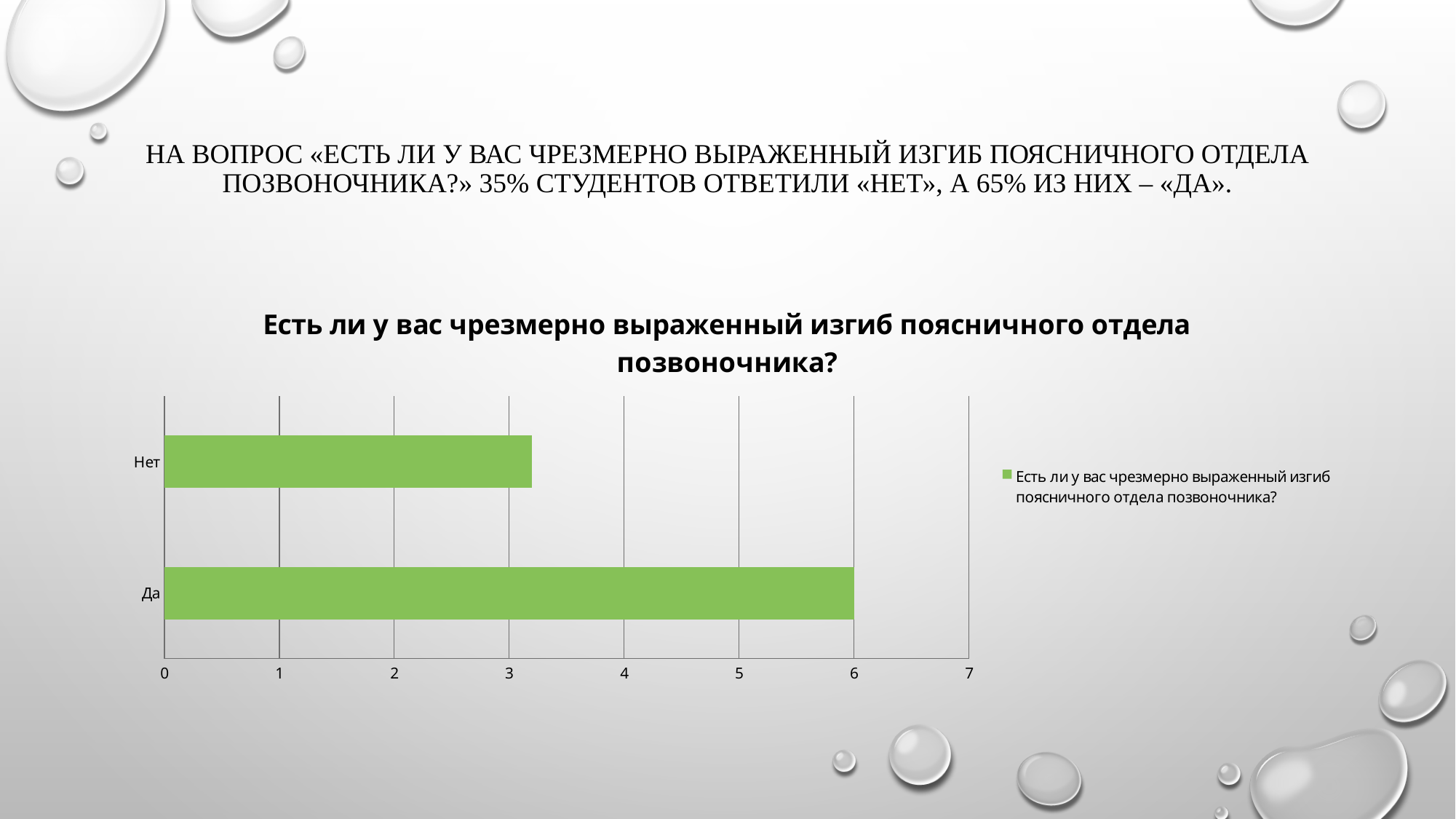
Which category has the lowest value? Нет Is the value for "Да" greater or less than 5? greater What is the title of the chart? Есть ли у вас чрезмерно выраженный изгиб поясничного отдела позвоночника? How many categories are plotted in the chart? 2 Which is larger, the value for "Да" or the value for "Нет"? Да What is the value for "Да"? 6 Which category has the highest value? Да Is the value for "Нет" greater or less than 3? greater What is the maximum value shown on the horizontal axis? 7 Is the value for "Нет" greater or less than 4? less How many series does the legend list? 1 What type of chart is shown on the slide? bar chart